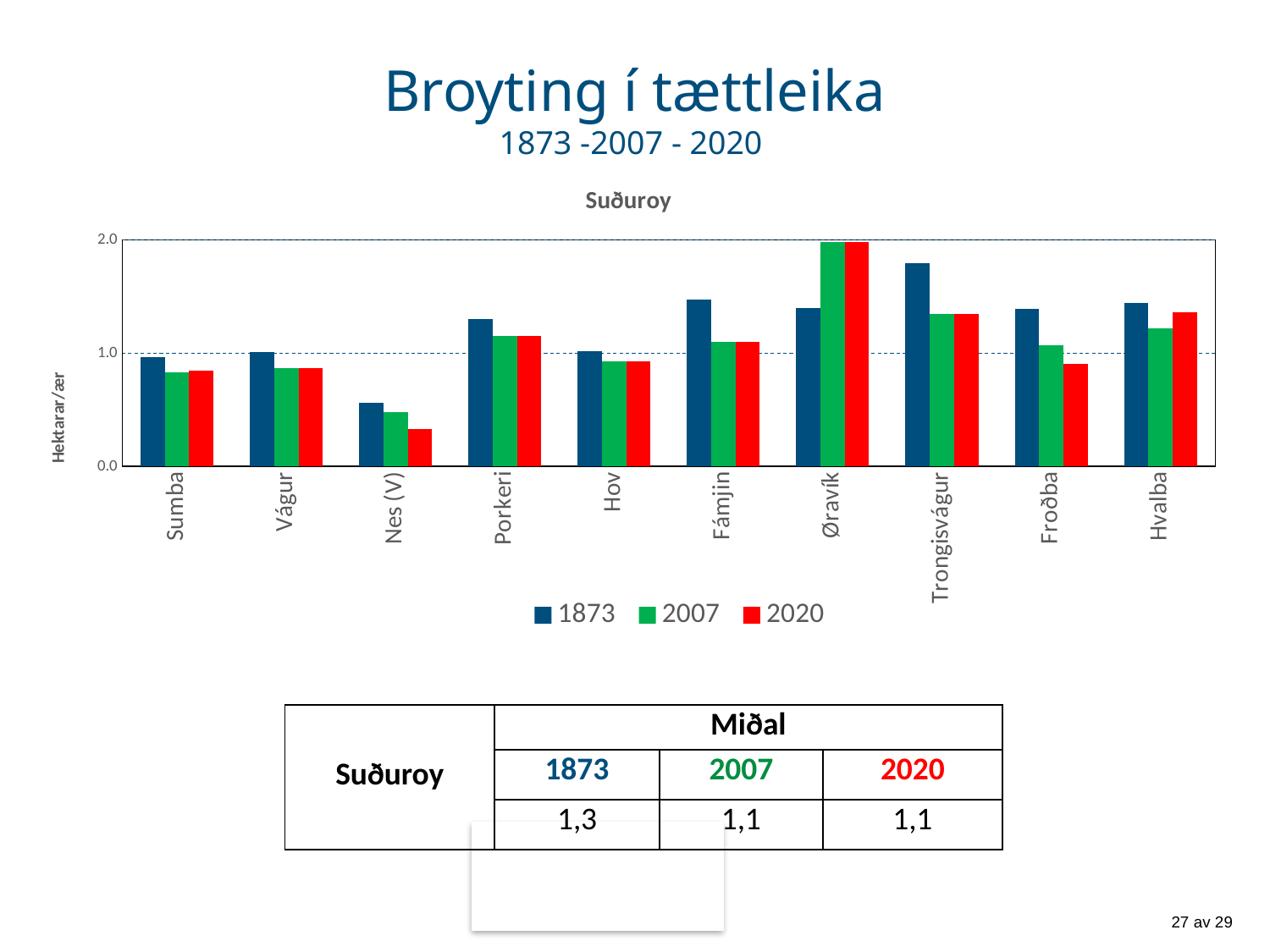
Which village has the lowest value for the 2020 series? Nes (V) Is the 1873 value for Trongisvágur greater or less than 1.0? greater Which is larger: the 1873 value for Trongisvágur or the 1873 value for Froðba? Trongisvágur How many series does the chart legend list? 3 Is the 2020 value for Froðba greater or less than 1.0? less What is the title shown above the chart? Suðuroy What kind of chart is shown on the slide? bar chart How many villages (categories) are shown on the x axis of the chart? 10 Which village has the lowest value for the 1873 series? Nes (V) Is the 2007 value for Sumba greater or less than 1.0? less Which is larger: the 2020 value for Sumba or the 2020 value for Nes (V)? Sumba Which village has the highest value for the 2007 series? Øravík